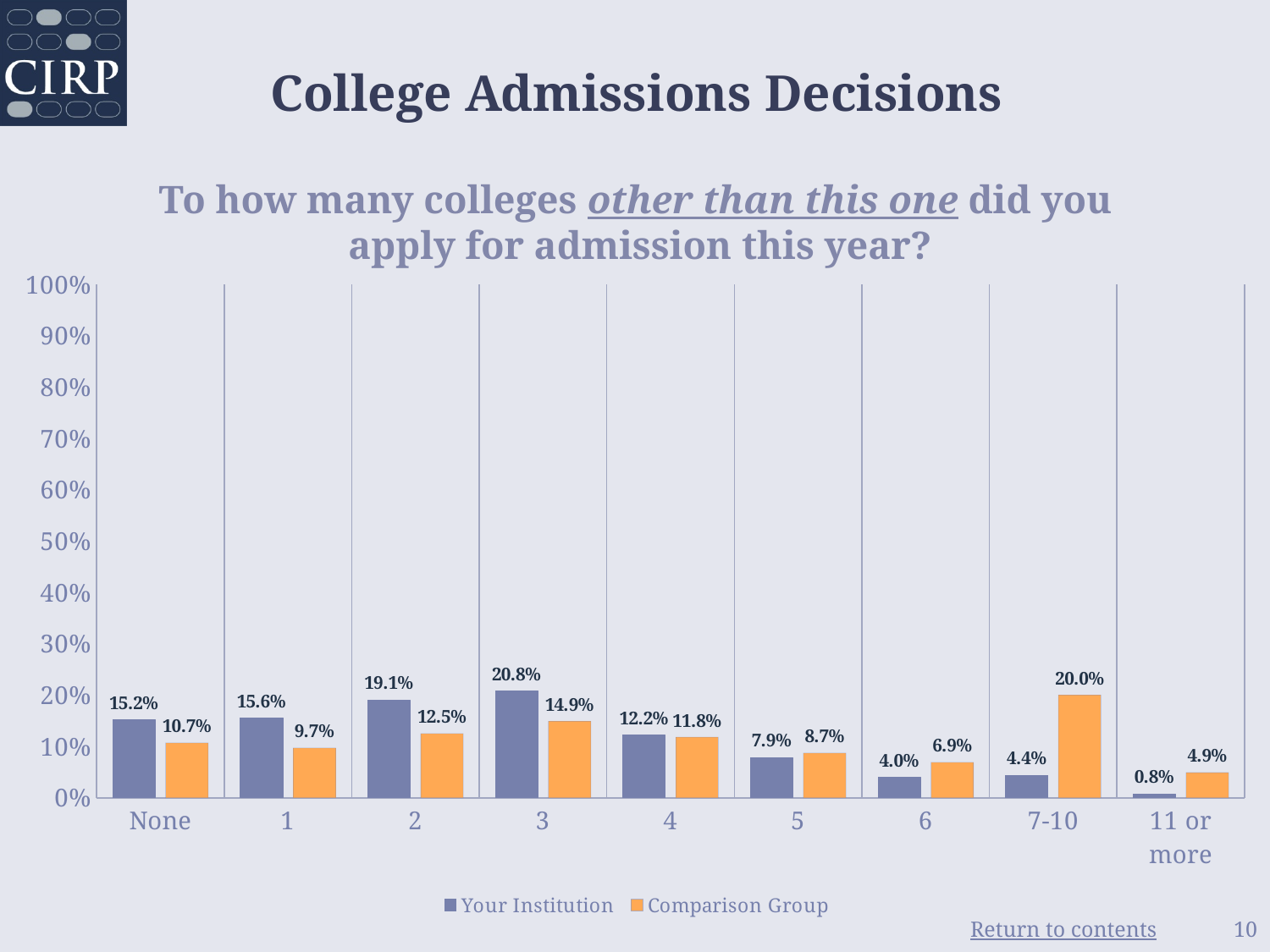
How many series does the legend list? 2 What is the value for Your Institution in the 'None' category? 15.2% What colour are the Comparison Group bars? Orange How many categories are shown on the x axis? 9 Which category has the highest value for Your Institution? 3 What is the value for Your Institution in the '3' category? 20.8% What is the value for Comparison Group in the '7-10' category? 20.0% Which is larger in the '1' category: Your Institution or Comparison Group? Your Institution What kind of chart is shown on the slide? Bar chart Is the value for Your Institution in the '2' category greater or less than 10%? greater Which category has the lowest value for Comparison Group? 11 or more What is the difference between Your Institution and Comparison Group in the '7-10' category? 15.6%